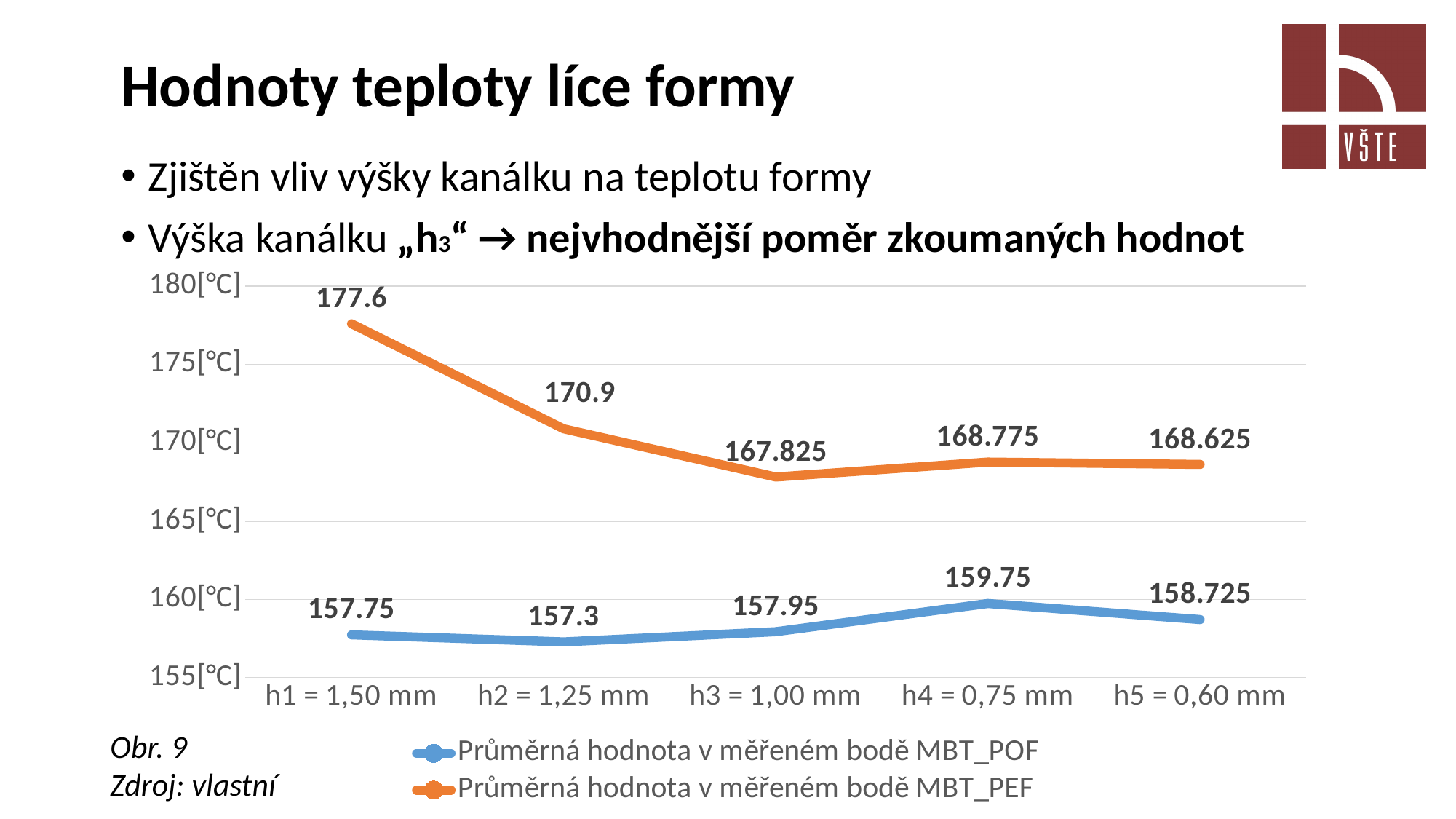
What is the value of the MBT_PEF series at h1 = 1,50 mm? 177.6 Which series has the larger value at h5 = 0,60 mm, MBT_POF or MBT_PEF? MBT_PEF Does the MBT_PEF series rise or fall from h1 = 1,50 mm to h3 = 1,00 mm? fall What is the value of the MBT_POF series at h4 = 0,75 mm? 159.75 What type of chart is shown on the slide? line chart How many categories are plotted along the x axis? 5 At which category is the MBT_PEF series highest? h1 = 1,50 mm How many series does the legend list? 2 Which colour is used for the MBT_POF series line? blue What is the value of the MBT_PEF series at h3 = 1,00 mm? 167.825 What is the difference between the MBT_PEF values at h1 = 1,50 mm and h2 = 1,25 mm? 6.7 At which category is the MBT_POF series lowest? h2 = 1,25 mm